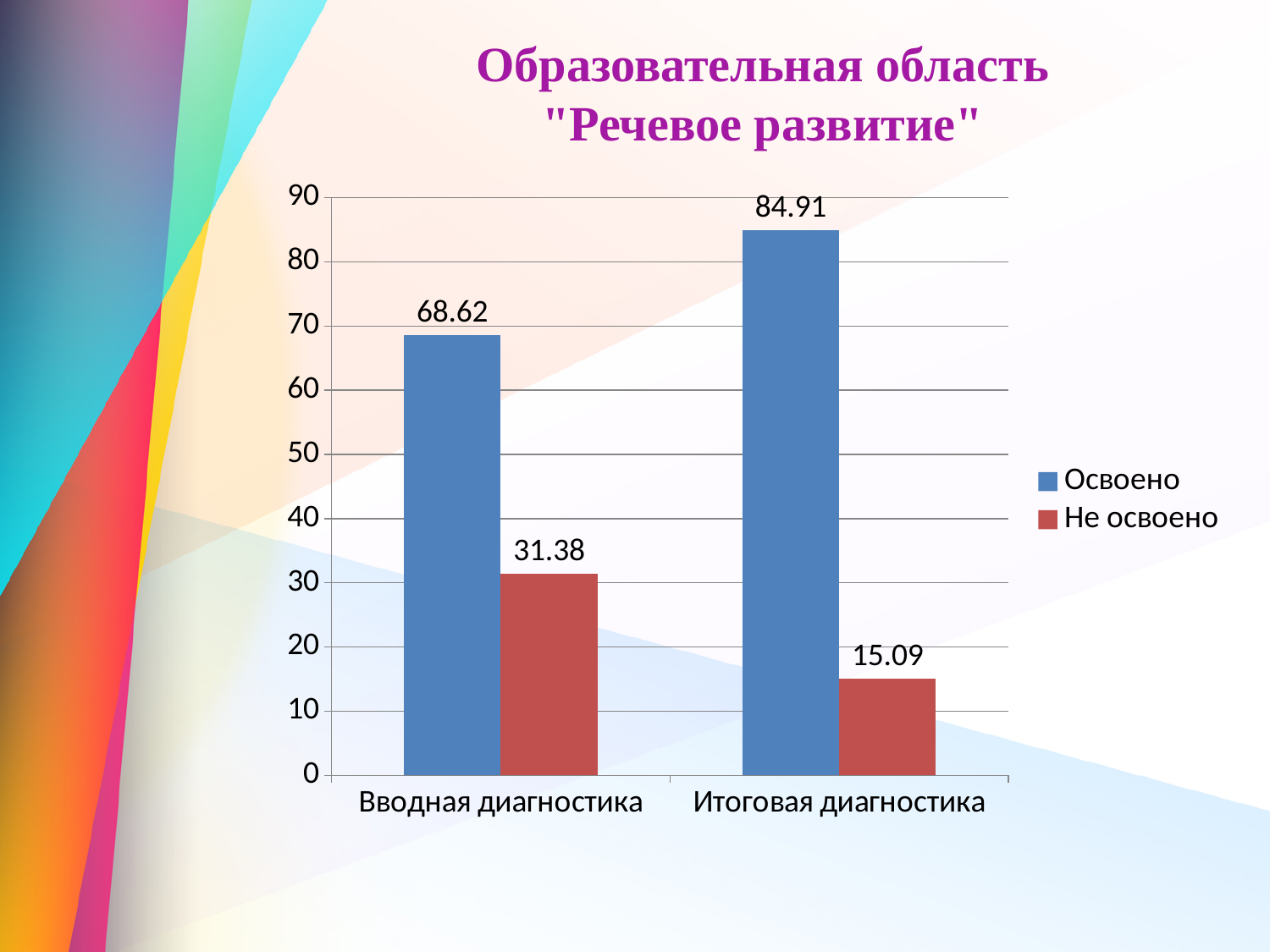
Which is larger: "Не освоено" for "Вводная диагностика" or "Не освоено" for "Итоговая диагностика"? Вводная диагностика How many categories are shown on the x axis? 2 What is the title of the chart? Образовательная область "Речевое развитие" Which category has the highest "Освоено" value? Итоговая диагностика How many series does the legend list? 2 Which category has the lowest "Не освоено" value? Итоговая диагностика What is the value of "Не освоено" for "Вводная диагностика"? 31.38 What is the difference between the "Освоено" values for "Итоговая диагностика" and "Вводная диагностика"? 16.29 What is the value of "Освоено" for "Вводная диагностика"? 68.62 Is the "Освоено" value for "Итоговая диагностика" greater or less than 80? greater What kind of chart is shown on the slide? bar chart What is the value of "Не освоено" for "Итоговая диагностика"? 15.09